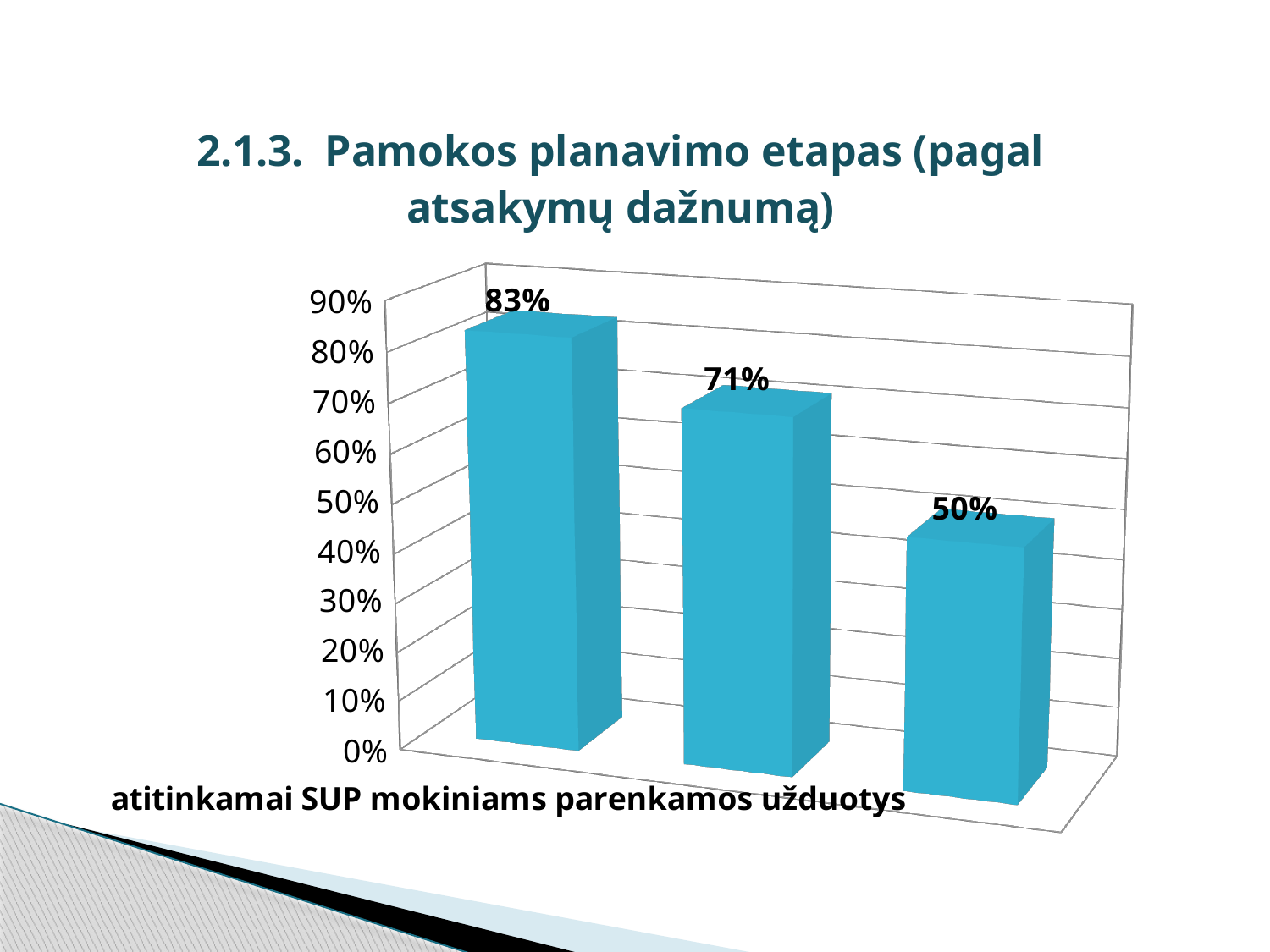
What is the difference between the leftmost bar's value and the middle bar's value? 12% Do the bar values rise or fall from left to right? fall What is the value shown on the rightmost bar? 50% Which bar has the lowest value: the leftmost, middle, or rightmost? rightmost How many bars are plotted in the chart? 3 What is the value shown on the leftmost bar? 83% What is the title of the slide containing the chart? 2.1.3. Pamokos planavimo etapas (pagal atsakymų dažnumą) Which is larger, the value of the middle bar or the value of the rightmost bar? the middle bar Which bar has the highest value: the leftmost, middle, or rightmost? leftmost What kind of chart is shown on the slide? bar chart What is the value shown on the middle bar? 71% What is the difference between the leftmost bar's value and the rightmost bar's value? 33%